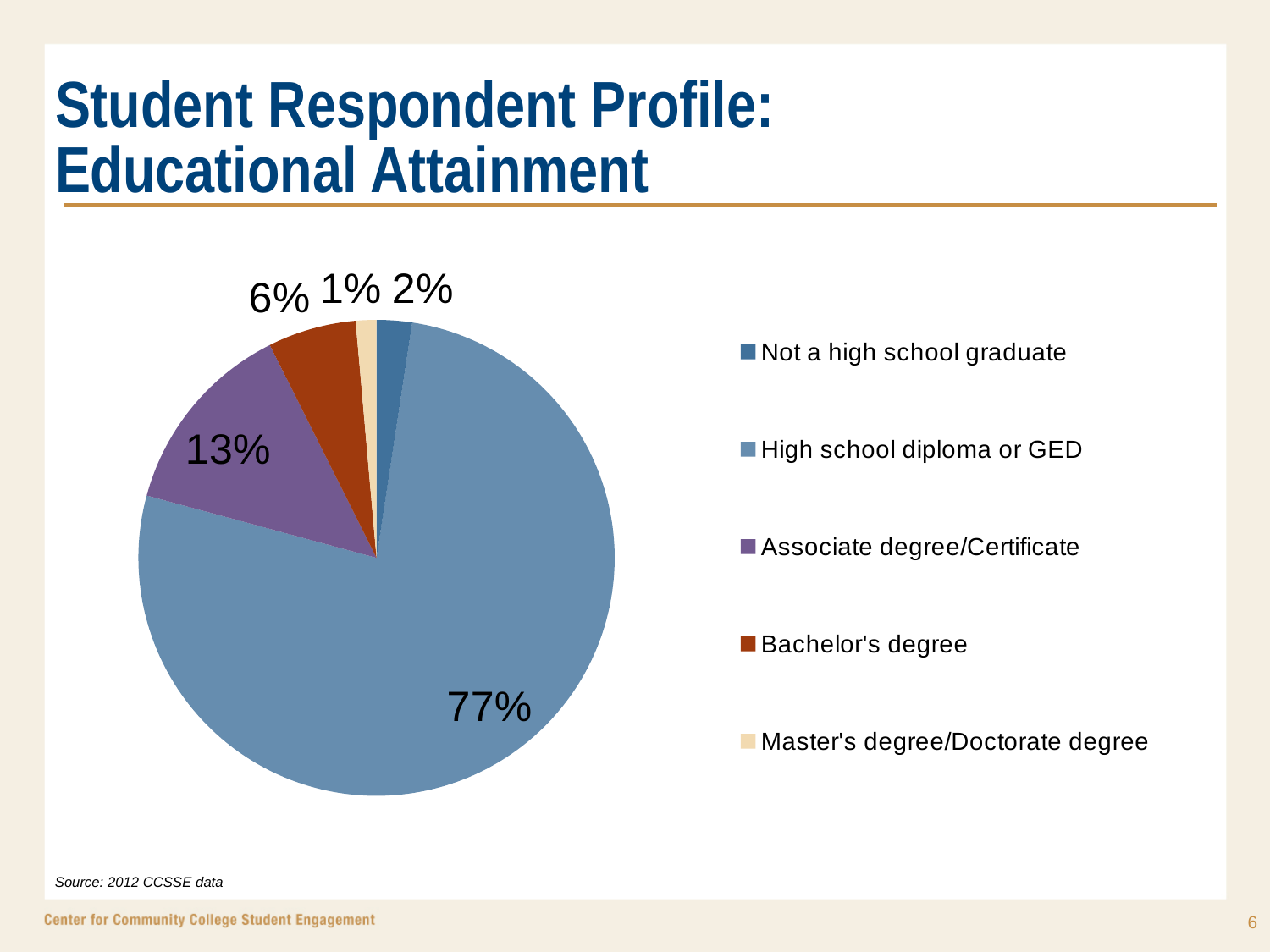
What is the title of the slide containing the chart? Student Respondent Profile: Educational Attainment What percentage of respondents have a Master's degree/Doctorate degree? 1% How many percentage points larger is the High school diploma or GED share than the Associate degree/Certificate share? 64 What percentage of respondents are not a high school graduate? 2% How many categories does the legend list? 5 Which educational attainment category has the smallest share of respondents? Master's degree/Doctorate degree What percentage of respondents have a high school diploma or GED? 77% What kind of chart is shown on the slide? pie chart Which educational attainment category has the largest share of respondents? High school diploma or GED What percentage of respondents have an Associate degree/Certificate? 13% Which is larger: the share for Bachelor's degree or the share for Not a high school graduate? Bachelor's degree What percentage of respondents have a Bachelor's degree? 6%